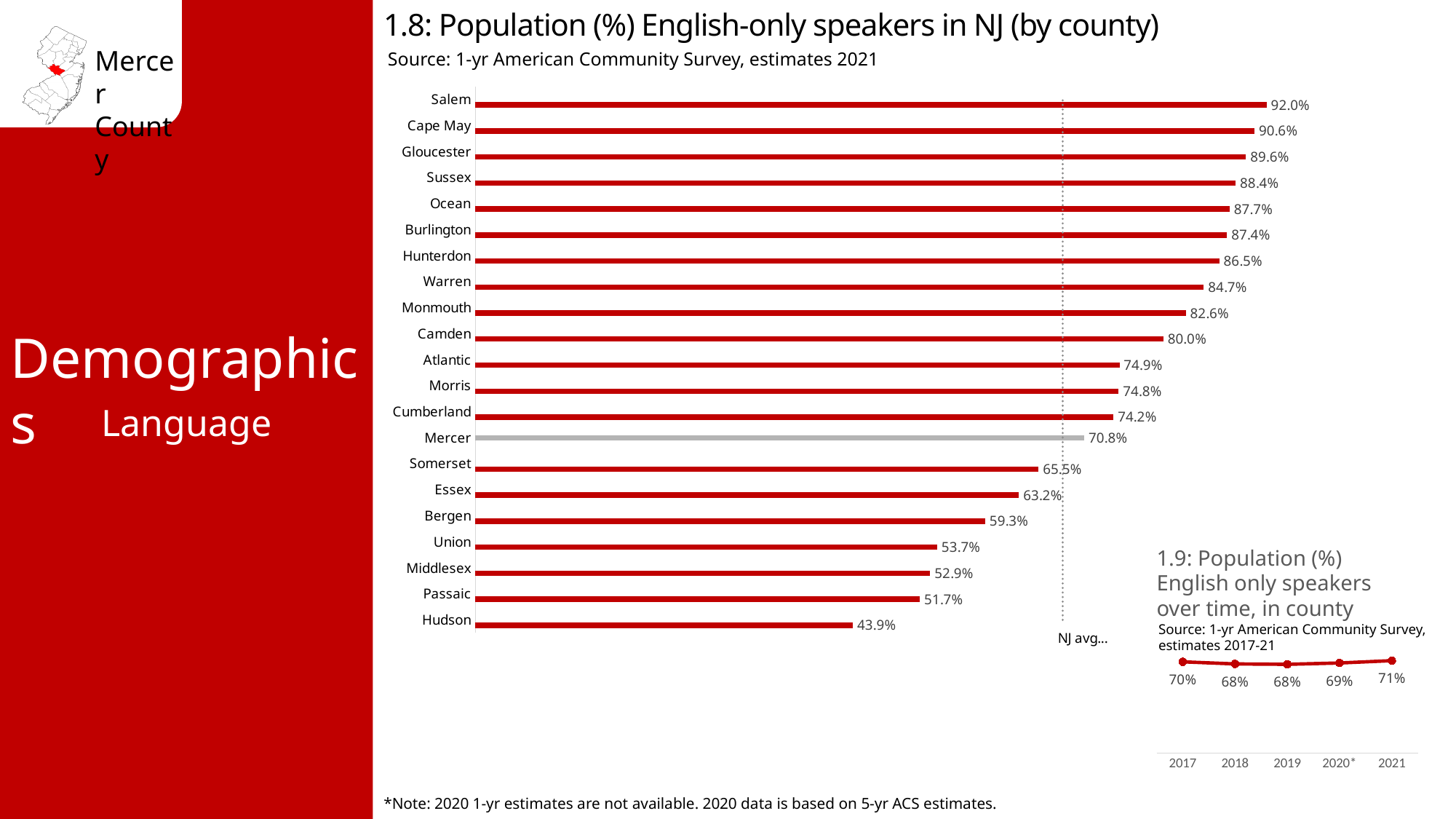
In the chart '1.8: Population (%) English-only speakers in NJ (by county)', what is the value for Hudson? 43.9% In the chart '1.8: Population (%) English-only speakers in NJ (by county)', which county has the highest value? Salem In the chart '1.9: Population (%) English only speakers over time, in county', what is the value for 2017? 70% In the chart '1.8: Population (%) English-only speakers in NJ (by county)', which county has the lowest value? Hudson In the chart '1.8: Population (%) English-only speakers in NJ (by county)', what is the value for Mercer? 70.8% What kind of chart is '1.8: Population (%) English-only speakers in NJ (by county)'? Bar chart What kind of chart is '1.9: Population (%) English only speakers over time, in county'? Line chart In the chart '1.8: Population (%) English-only speakers in NJ (by county)', which is larger, Bergen or Union? Bergen In the chart '1.8: Population (%) English-only speakers in NJ (by county)', what is the difference between Salem and Hudson? 48.1% In the chart '1.8: Population (%) English-only speakers in NJ (by county)', how many counties are shown? 21 In the chart '1.9: Population (%) English only speakers over time, in county', what is the value for 2021? 71% In the chart '1.9: Population (%) English only speakers over time, in county', how many years are plotted? 5